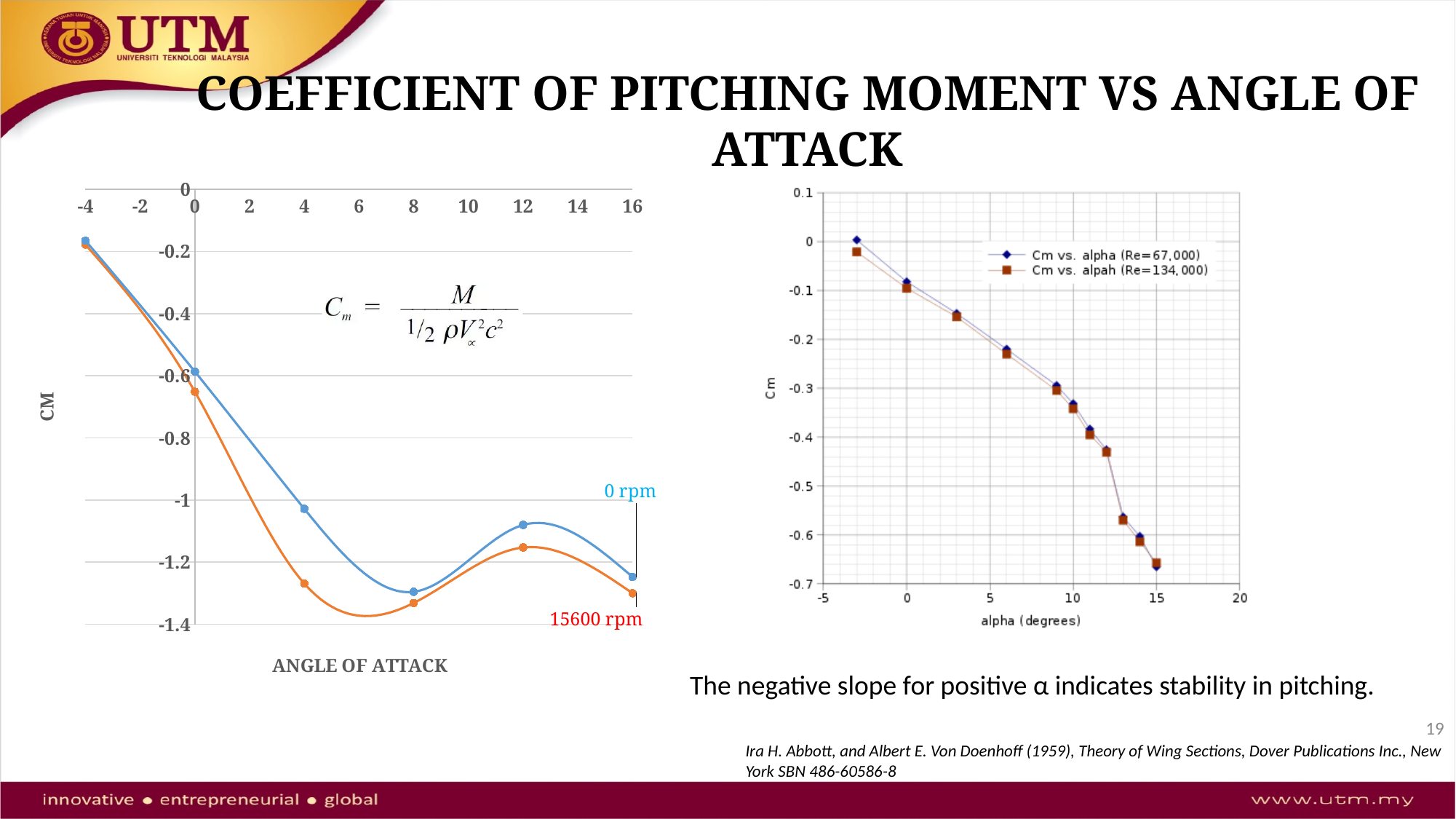
On the left chart (CM vs angle of attack), how many data points does the 0 rpm series have? 6 On the right chart (Cm vs alpha), does Cm rise or fall as alpha increases? fall On the left chart (CM vs angle of attack), at which angle of attack does the 0 rpm series reach its lowest CM value? 8 On the left chart (CM vs angle of attack), what kind of chart is it? line chart On the right chart (Cm vs alpha), at alpha = 15 degrees, is the Cm value for Re=67,000 greater or less than -0.6? less On the left chart (CM vs angle of attack), at an angle of attack of 4, which series has the higher CM value, 0 rpm or 15600 rpm? 0 rpm On the left chart (CM vs angle of attack), at an angle of attack of 0, is the 15600 rpm value greater or less than -0.6? less On the left chart (CM vs angle of attack), how many series are plotted? 2 On the left chart (CM vs angle of attack), what are the two series labelled? 0 rpm and 15600 rpm On the right chart (Cm vs alpha), how many series does the legend list? 2 On the left chart (CM vs angle of attack), at an angle of attack of 8, is the 0 rpm value greater or less than -1.2? less